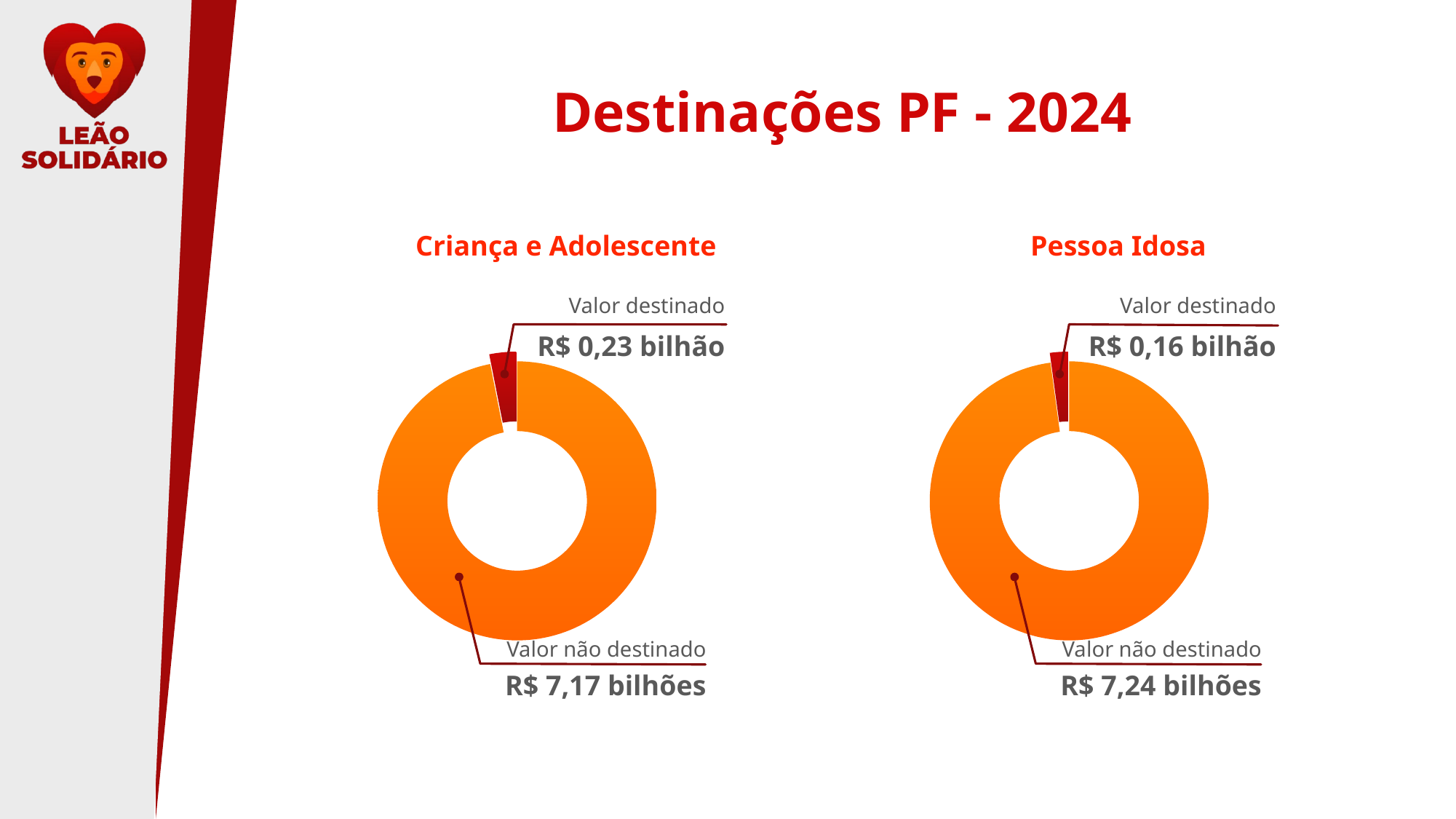
In the Pessoa Idosa chart, what is the difference between Valor não destinado and Valor destinado? R$ 7,08 bilhões In the Criança e Adolescente chart, which slice is the largest? Valor não destinado In the Criança e Adolescente chart, what is the difference between Valor não destinado and Valor destinado? R$ 6,94 bilhões In the Pessoa Idosa chart, which slice is the smallest? Valor destinado Which chart shows a larger Valor destinado, Criança e Adolescente or Pessoa Idosa? Criança e Adolescente How many slices does the Criança e Adolescente chart have? 2 In the Criança e Adolescente chart, what is the value for Valor não destinado? R$ 7,17 bilhões In the Pessoa Idosa chart, what is the value for Valor não destinado? R$ 7,24 bilhões In the Criança e Adolescente chart, what is the value for Valor destinado? R$ 0,23 bilhão What kind of chart is the Pessoa Idosa chart? Donut (pie) chart In the Pessoa Idosa chart, what is the value for Valor destinado? R$ 0,16 bilhão What is the title of the slide containing the two charts? Destinações PF - 2024